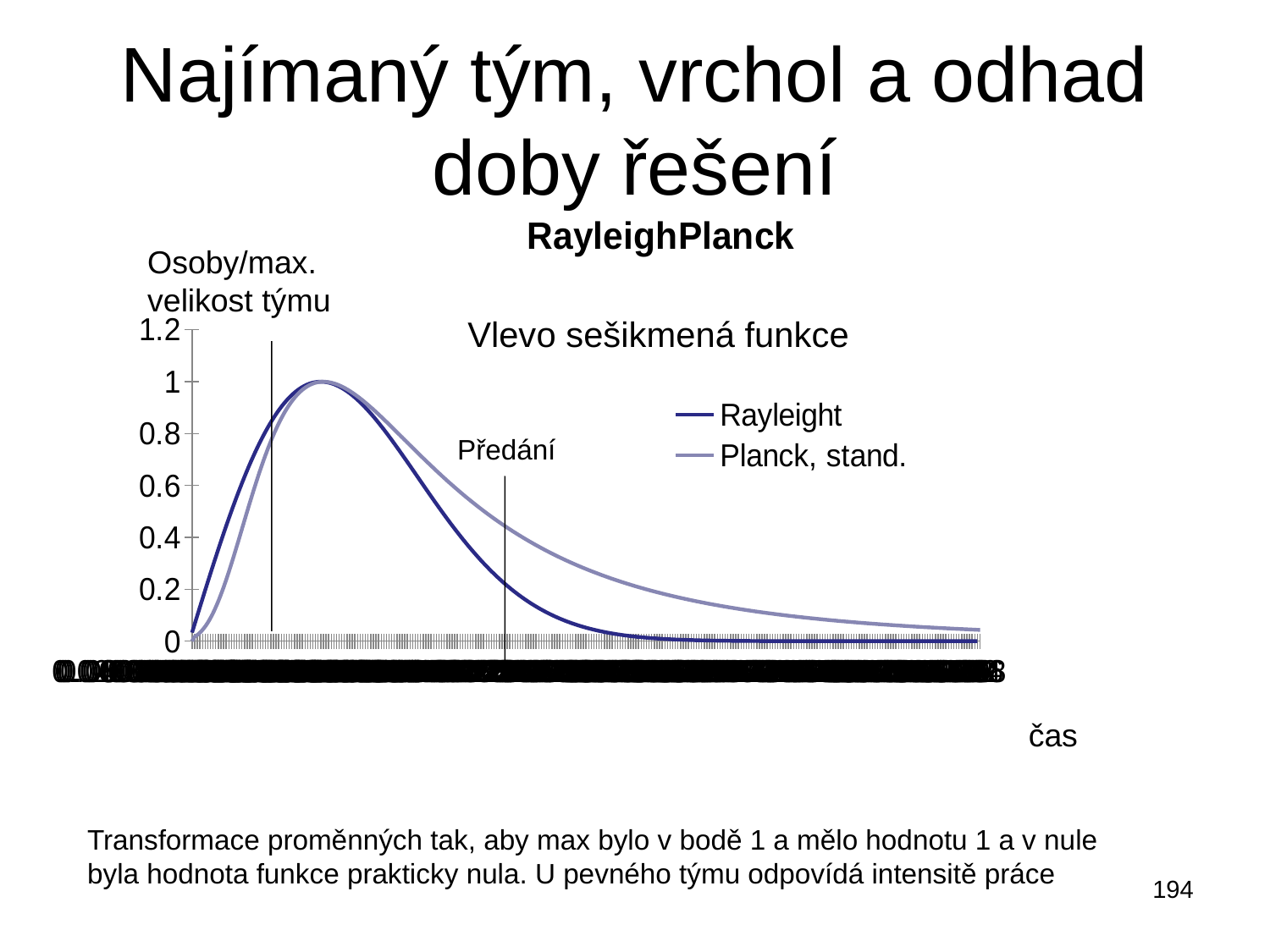
After reaching their peak, do the two curves rise or fall as the x axis increases? fall How many series does the chart legend list? 2 What is the peak value reached by both curves in the chart? 1 What is the title of the chart? RayleighPlanck What kind of chart is shown on the slide? line chart What are the two series named in the chart legend? Rayleight; Planck, stand. At the vertical line labelled 'Předání', is the value of the Rayleight series greater or less than 0.4? less At the vertical line labelled 'Předání', is the value of the Planck, stand. series greater or less than 0.2? greater At the right end of the x axis, which series has the larger value, Rayleight or Planck, stand.? Planck, stand. Which series falls to nearly zero faster after the peak, Rayleight or Planck, stand.? Rayleight What is the highest tick value shown on the vertical axis of the chart? 1.2 At the vertical line labelled 'Předání', which series has the larger value, Rayleight or Planck, stand.? Planck, stand.